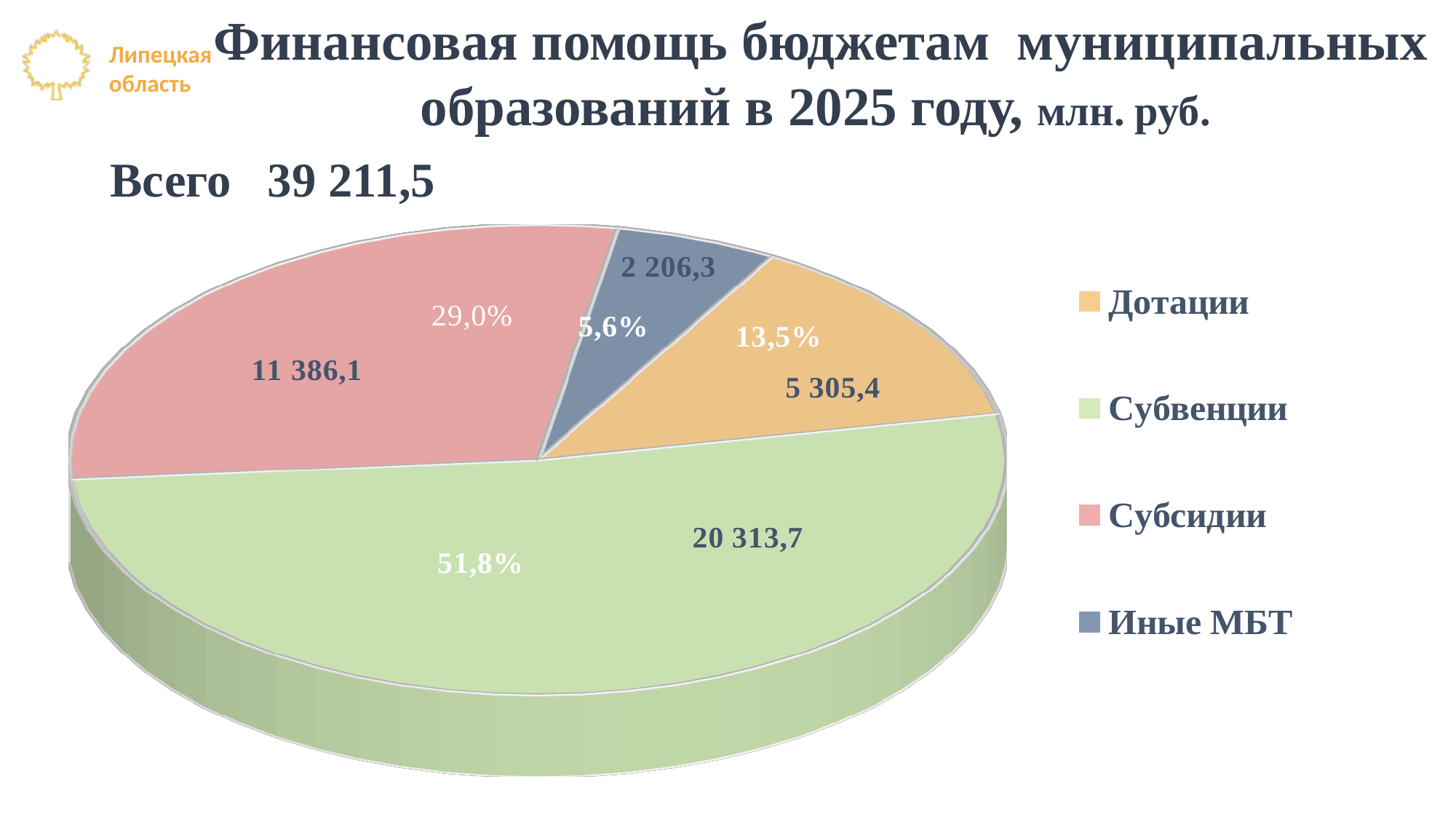
What total value (Всего) is shown on the slide? 39 211,5 Which category has the largest slice? Субвенции What is the value for Субсидии? 11 386,1 What share of the pie does Иные МБТ represent? 5,6% What is the value for Иные МБТ? 2 206,3 Which is larger, Субсидии or Дотации? Субсидии What kind of chart is shown on the slide? pie chart How many slices does the pie chart have? 4 What is the value for Дотации? 5 305,4 What share of the pie does Субвенции represent? 51,8% Which category has the smallest slice? Иные МБТ What is the value for Субвенции? 20 313,7